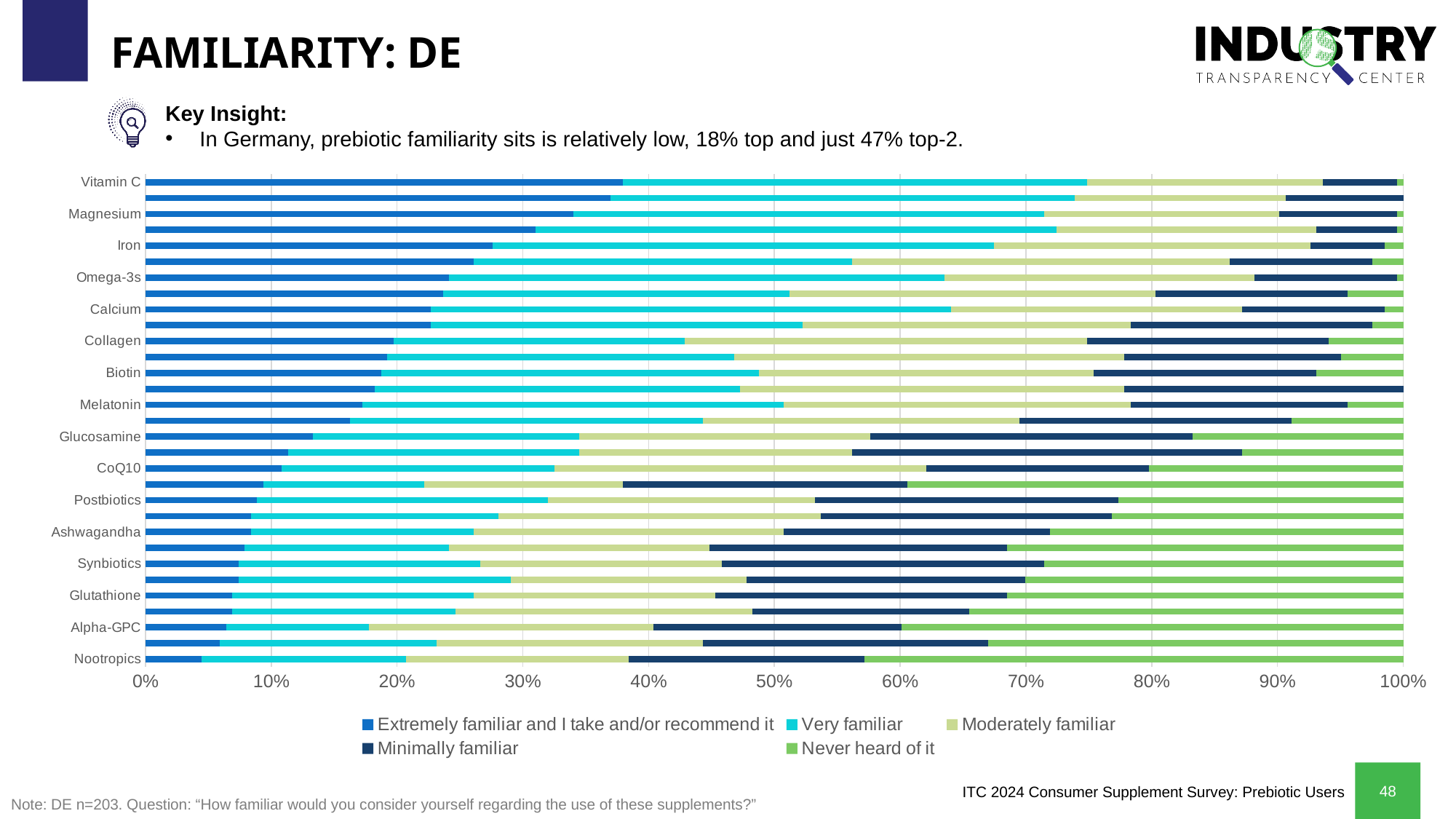
Is the 'Extremely familiar and I take and/or recommend it' value for Nootropics greater or less than 10%? less Which supplement has the highest share of 'Extremely familiar and I take and/or recommend it'? Vitamin C Which has a larger 'Extremely familiar and I take and/or recommend it' share, Vitamin C or Nootropics? Vitamin C Is the 'Extremely familiar and I take and/or recommend it' value for Iron greater or less than 30%? less Which has a larger 'Never heard of it' share, Nootropics or Vitamin C? Nootropics How many series does the legend list? 5 Moving from the top bar (Vitamin C) down to the bottom bar (Nootropics), does the 'Extremely familiar and I take and/or recommend it' share rise or fall? fall Which labeled supplement has the lowest share of 'Extremely familiar and I take and/or recommend it'? Nootropics Is the 'Extremely familiar and I take and/or recommend it' value for Vitamin C greater or less than 30%? greater What kind of chart is shown on the slide? stacked bar chart What is the title of the slide containing the chart? FAMILIARITY: DE